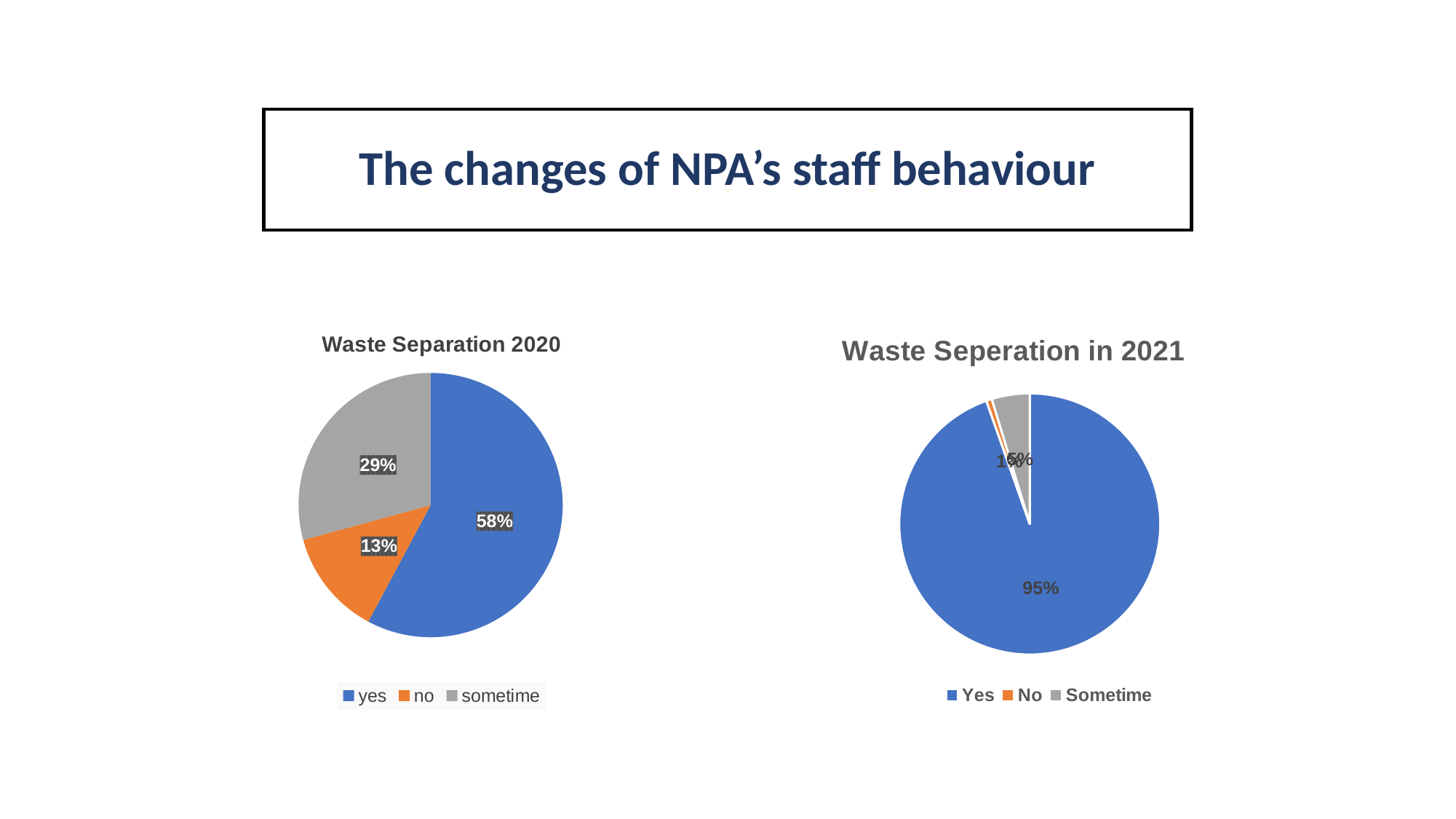
How many categories does the legend of the Waste Seperation in 2021 chart list? 3 In the Waste Seperation in 2021 chart, what share of staff answered Yes? 95% In the Waste Separation 2020 chart, which response has the smallest share? no What type of chart is the Waste Separation 2020 chart? Pie chart What colour represents the Yes category in the Waste Seperation in 2021 chart? Blue Which is larger in the Waste Separation 2020 chart: the share for no or the share for sometime? sometime In the Waste Separation 2020 chart, what share of staff answered yes? 58% In the Waste Separation 2020 chart, what share of staff answered sometime? 29% In the Waste Separation 2020 chart, what is the difference between the yes share and the sometime share? 29% In the Waste Separation 2020 chart, what share of staff answered no? 13% In the Waste Seperation in 2021 chart, which response has the largest share? Yes In the Waste Separation 2020 chart, which response has the largest share? yes